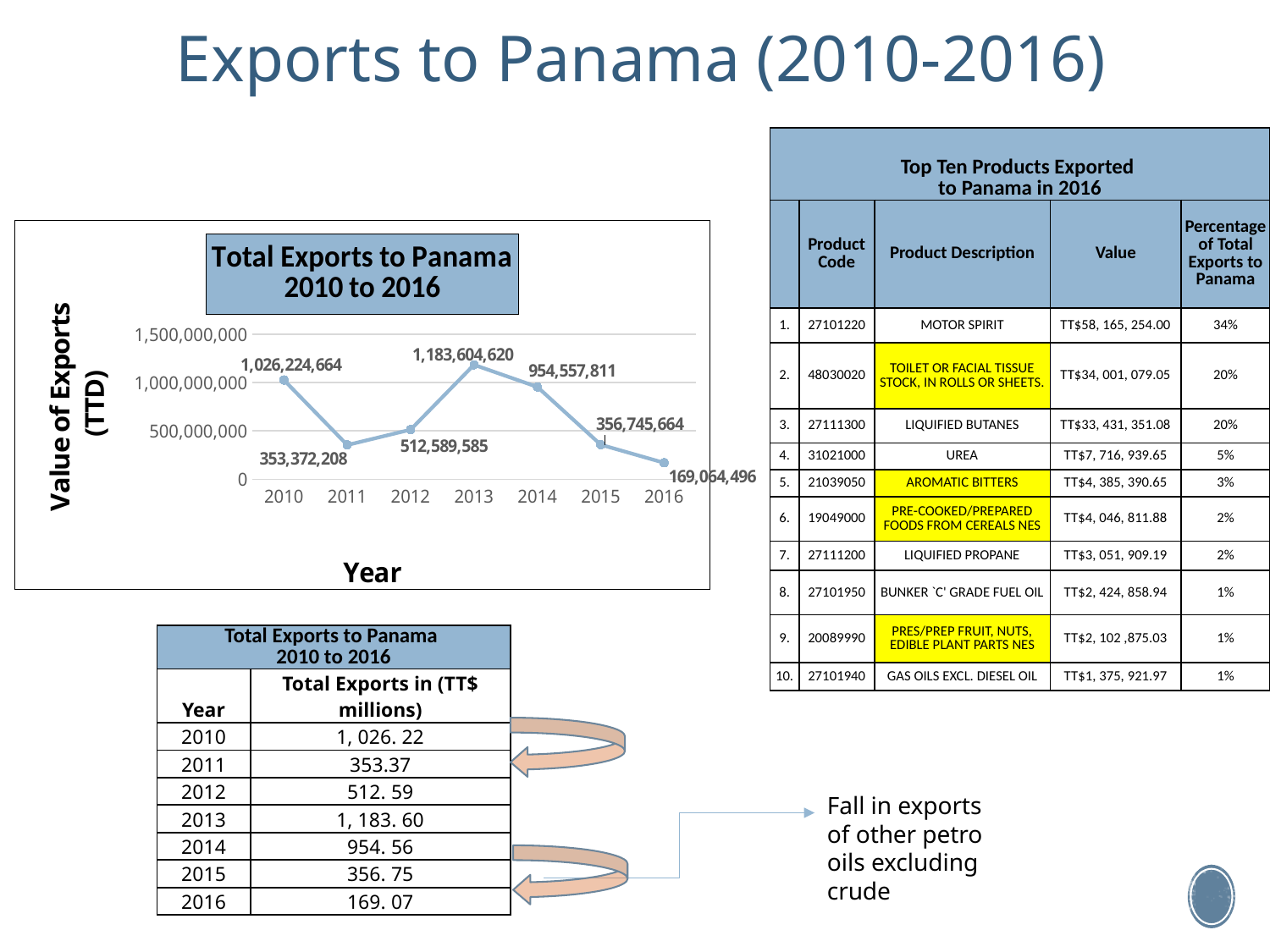
What is the value of exports to Panama in 2016? 169,064,496 What type of chart is shown on the slide? line chart What is the difference between the export values for 2014 and 2015? 597,812,147 Do the export values rise or fall from 2013 to 2016? fall Which year has the lowest value of exports to Panama? 2016 What is the value of exports to Panama in 2013? 1,183,604,620 What is the value of exports to Panama in 2011? 353,372,208 Which year has the highest value of exports to Panama? 2013 Which year has a larger export value, 2012 or 2014? 2014 What is the title of the chart? Total Exports to Panama 2010 to 2016 How much higher is the export value in 2013 than in 2010? 157,379,956 How many years are plotted on the chart? 7